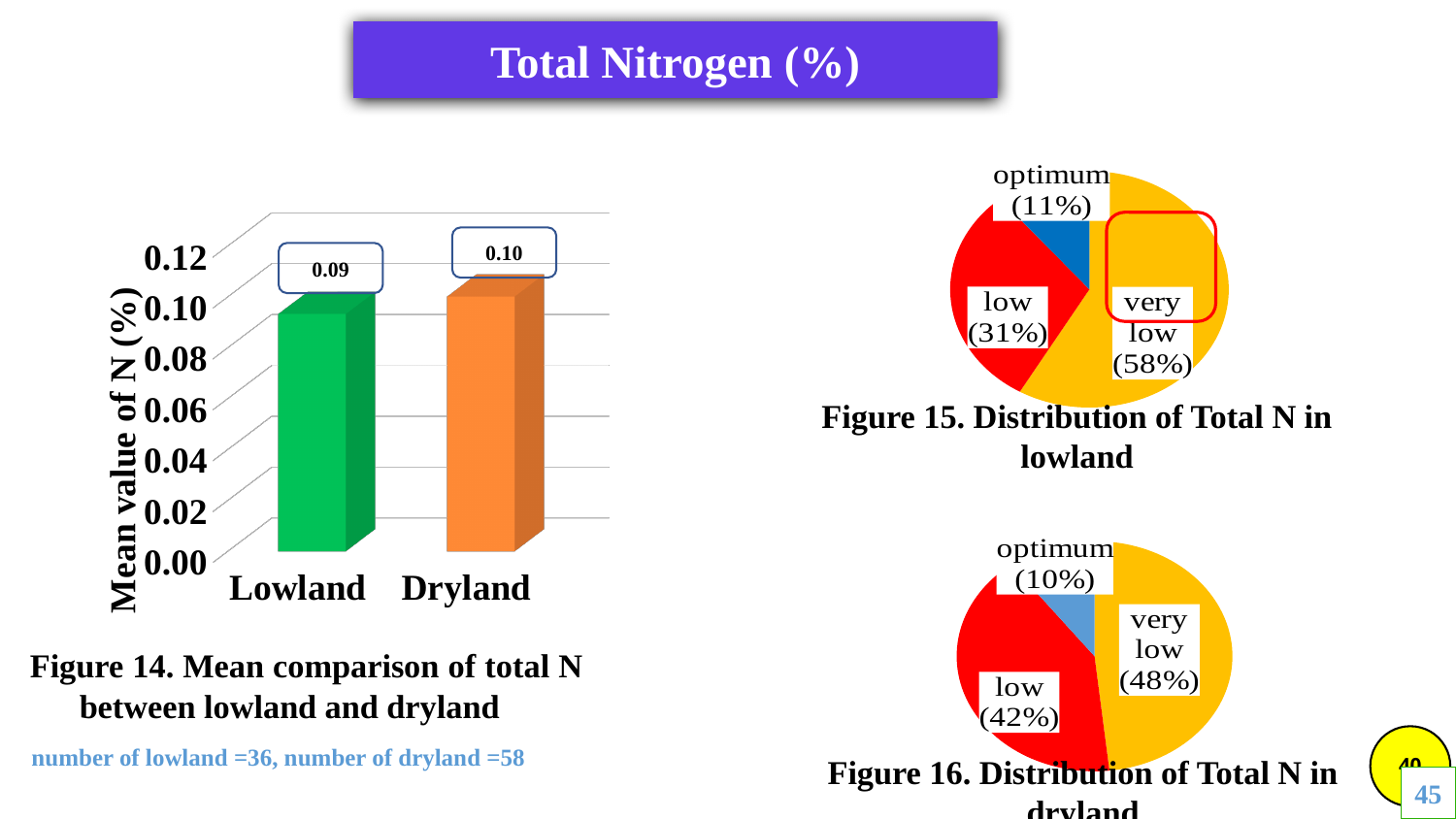
In Figure 16 (Distribution of Total N in dryland), how many slices does the pie have? 3 In Figure 14, what is the mean value of N (%) for Lowland? 0.09 In Figure 16 (Distribution of Total N in dryland), which category has the largest share? very low In Figure 15 (Distribution of Total N in lowland), what share is 'optimum'? 11% In Figure 14, how many categories are plotted? 2 In Figure 16 (Distribution of Total N in dryland), what share is 'low'? 42% In Figure 15 (Distribution of Total N in lowland), what share is 'very low'? 58% In Figure 14, what is the difference between the Dryland and Lowland mean values of N (%)? 0.01 In Figure 15 (Distribution of Total N in lowland), which category has the smallest share? optimum In Figure 14, what is the mean value of N (%) for Dryland? 0.10 In Figure 14, which category has the higher mean value of N? Dryland What kind of chart is Figure 14? Bar chart